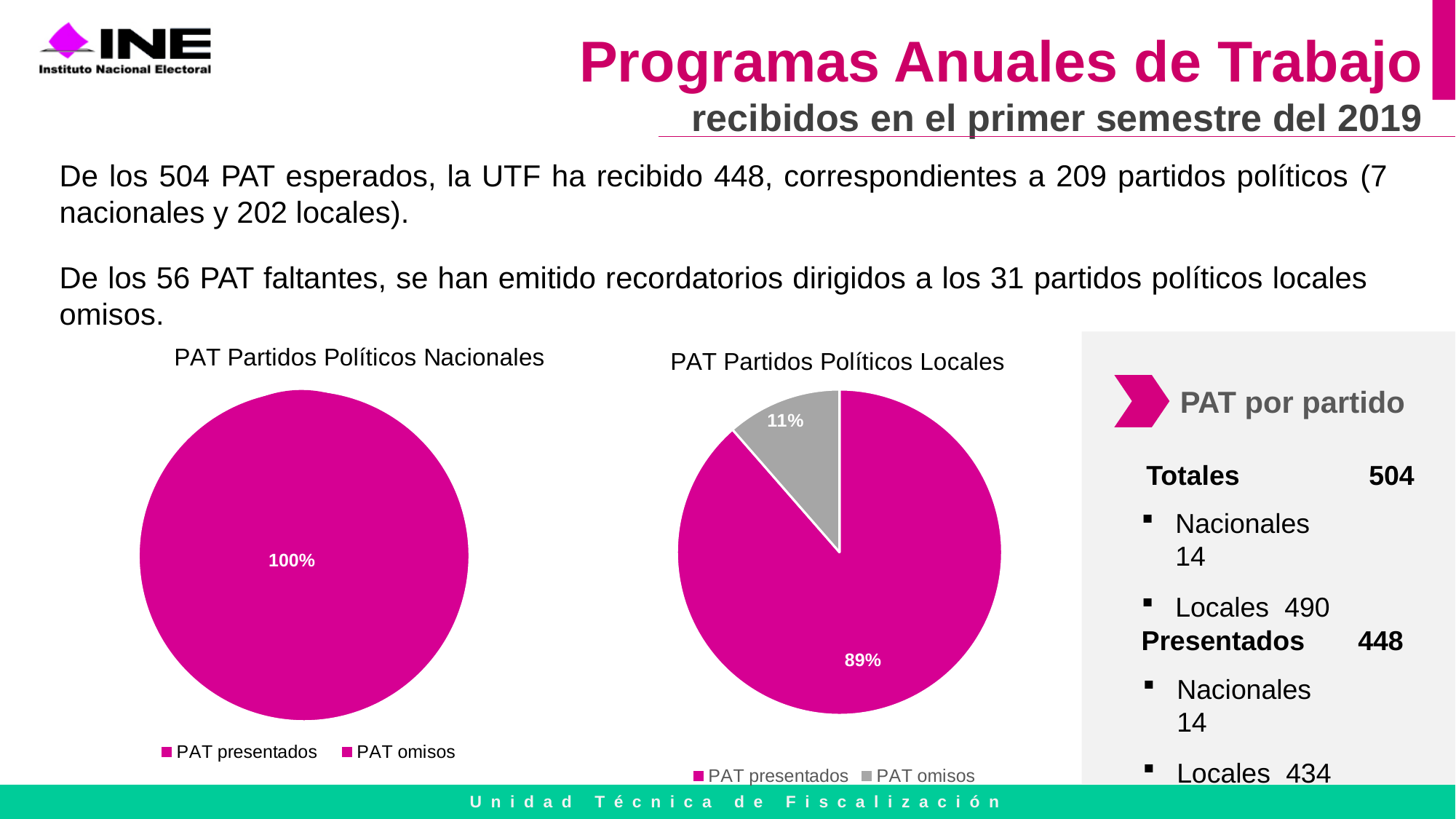
In the 'PAT Partidos Políticos Locales' chart, what is the difference in percentage points between PAT presentados and PAT omisos? 78 percentage points How many entries does the legend of the 'PAT Partidos Políticos Locales' chart list? 2 In the 'PAT Partidos Políticos Locales' chart, which slice is the smallest? PAT omisos What kind of chart is the 'PAT Partidos Políticos Locales' chart? pie chart In the 'PAT Partidos Políticos Locales' chart, which slice is the largest? PAT presentados In the 'PAT Partidos Políticos Locales' chart, what share of the pie is PAT omisos? 11% In the 'PAT Partidos Políticos Nacionales' chart, what share of the pie is PAT presentados? 100% How many pie charts are shown on the slide? 2 What is the title of the pie chart on the left of the slide? PAT Partidos Políticos Nacionales In the 'PAT Partidos Políticos Locales' chart, what colour is the PAT omisos slice? grey In the 'PAT Partidos Políticos Locales' chart, which is larger, PAT presentados or PAT omisos? PAT presentados In the 'PAT Partidos Políticos Locales' chart, what share of the pie is PAT presentados? 89%